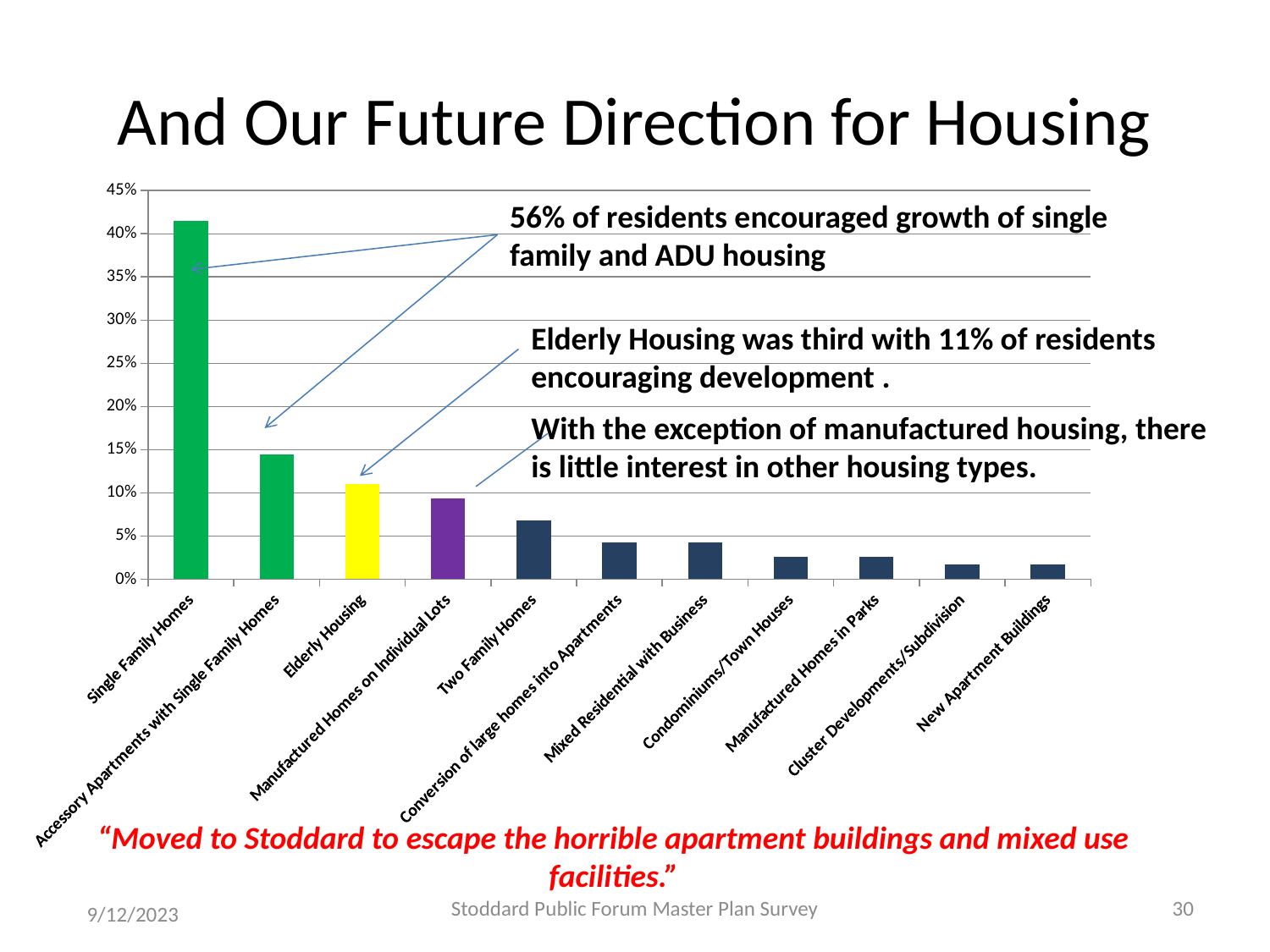
How many housing categories are plotted on the chart? 11 Do the bar values rise or fall moving from left to right along the x axis? fall Which is larger, the value for Two Family Homes or the value for Condominiums/Town Houses? Two Family Homes Is the value for Accessory Apartments with Single Family Homes greater or less than 10%? greater Which housing category has the highest value on the chart? Single Family Homes Is the value for Elderly Housing greater or less than 15%? less What kind of chart is shown on the slide? bar chart Is the value for Single Family Homes greater or less than 40%? greater What colour is the bar for Elderly Housing? yellow Which is larger, the value for Single Family Homes or the value for Accessory Apartments with Single Family Homes? Single Family Homes